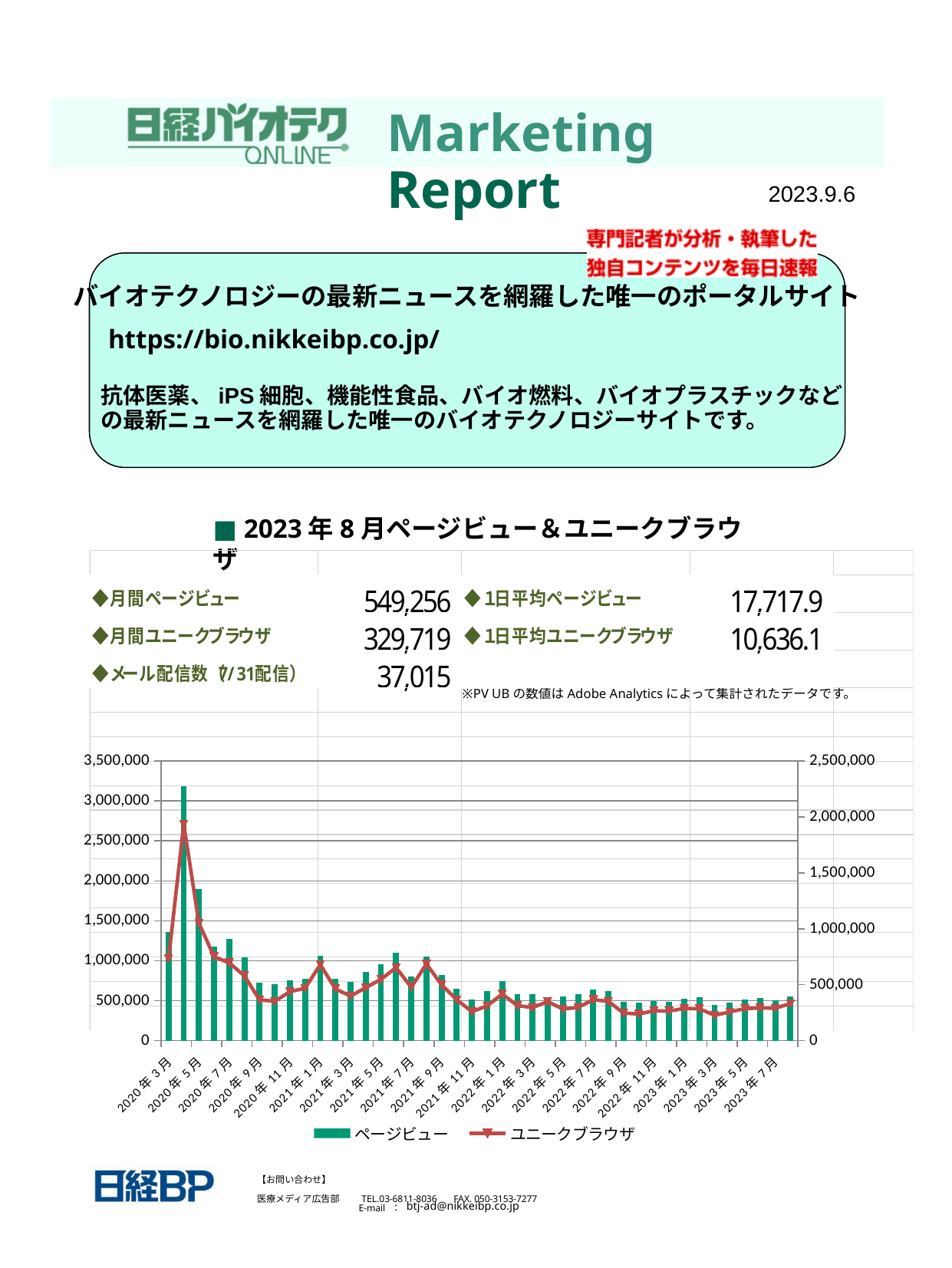
How many series does the chart legend list? 2 Which two series are listed in the chart legend? ページビュー and ユニークブラウザ Is the unique browsers value for 2020年4月 greater or less than 1,500,000 on the right axis? greater Is the page view value for 2020年5月 greater or less than 2,000,000? less In which month do the page views (ページビュー) bars reach their highest value? 2020年4月 Which series is drawn as bars in the chart? ページビュー Is the page view value for 2020年4月 greater or less than 3,000,000? greater In which month does the unique browsers (ユニークブラウザ) line reach its highest value? 2020年4月 Which month has the larger page view value, 2020年4月 or 2021年1月? 2020年4月 Overall, do the page view values rise or fall from 2020年4月 to 2023年7月? fall What kind of chart is shown on the slide? A combination bar and line chart